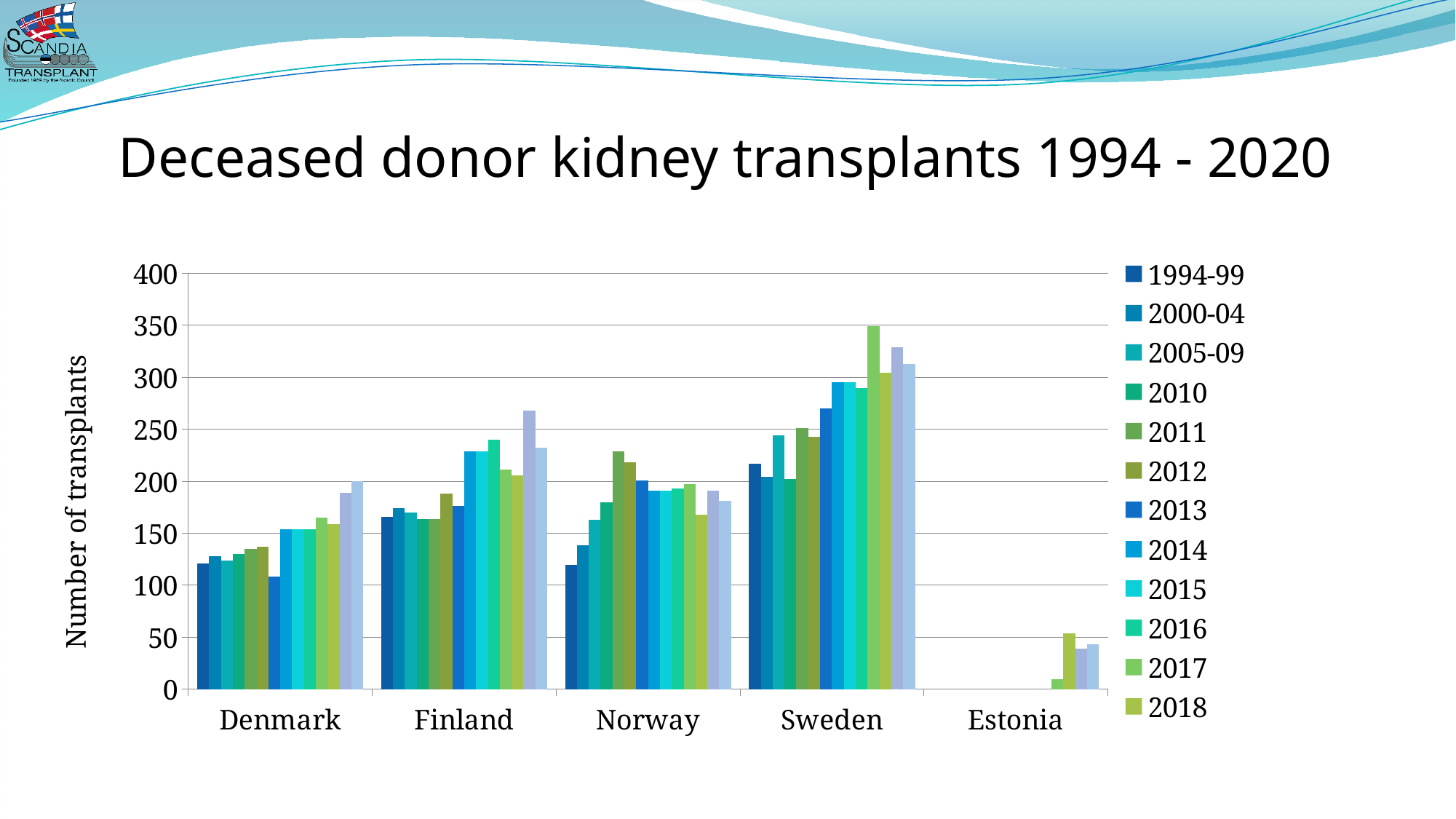
Which is larger, the 2017 value for Sweden or the 2017 value for Denmark? Sweden Which country has the lowest number of deceased donor kidney transplants in the chart? Estonia What kind of chart is shown on the slide? bar chart How many series does the visible legend list? 12 Do the values for Denmark generally rise or fall across the periods from 1994-99 onward? rise Is the value for Norway in 2011 greater or less than 200? greater How many countries are shown on the x axis of the chart? 5 What is the label on the vertical axis of the chart? Number of transplants Which country has the highest number of deceased donor kidney transplants in the chart? Sweden Is the value for Denmark in 1994-99 greater or less than 150? less Is the value for Sweden in 2017 greater or less than 300? greater